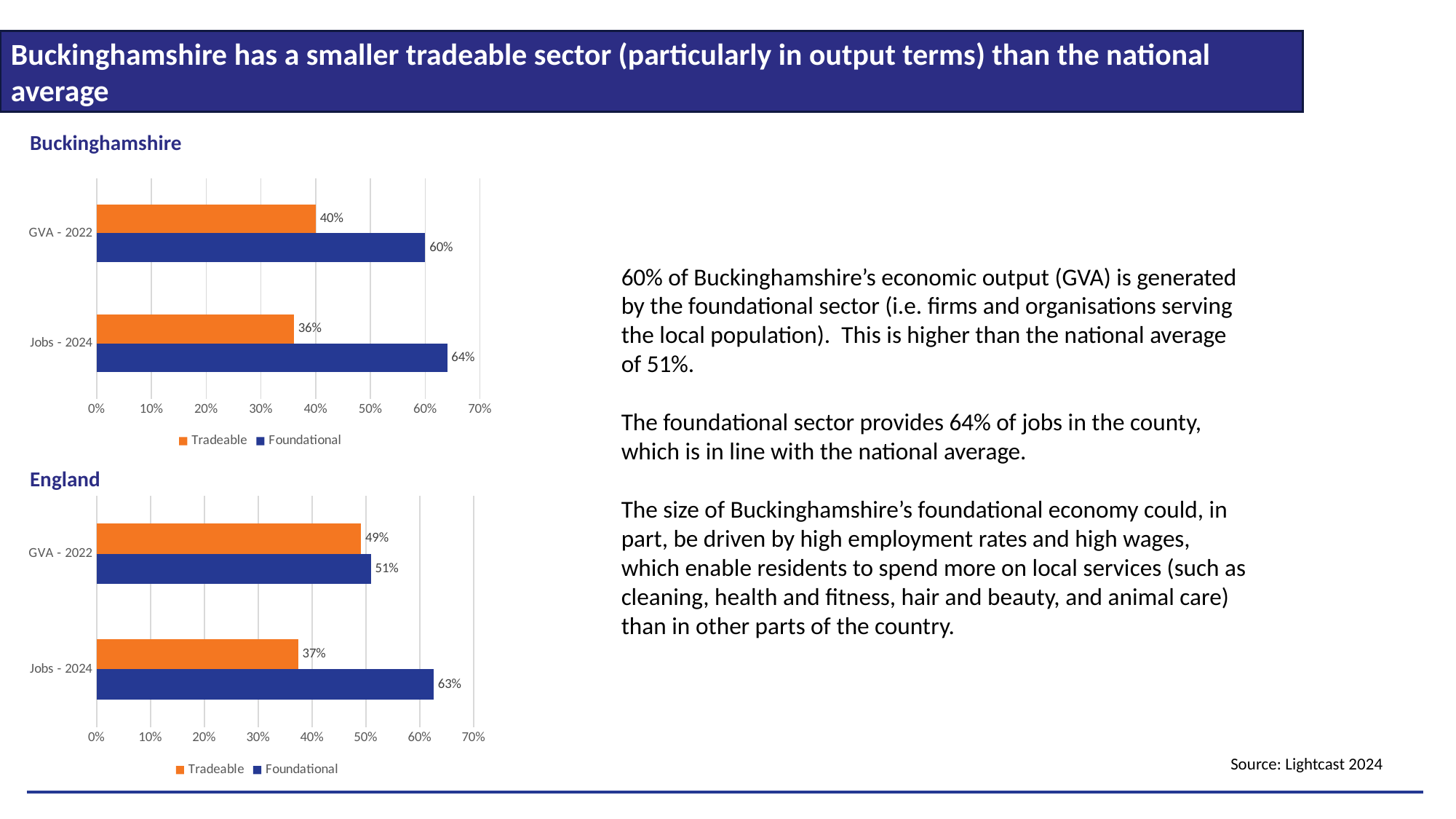
In the Buckinghamshire chart, what is the difference between the Foundational and Tradeable values for GVA - 2022? 20% What kind of chart is the England chart? Bar chart In the England chart, what is the Tradeable value for GVA - 2022? 49% In the England chart, which bar has the lowest value? Tradeable, Jobs - 2024 How many series does the legend of the England chart list? 2 In the England chart, what is the difference between the Foundational and Tradeable values for Jobs - 2024? 26% How many categories are shown on the y axis of the Buckinghamshire chart? 2 In the Buckinghamshire chart, what is the Tradeable value for Jobs - 2024? 36% In the Buckinghamshire chart, which series has the larger value for Jobs - 2024, Tradeable or Foundational? Foundational In the Buckinghamshire chart, what is the Foundational value for GVA - 2022? 60% In the Buckinghamshire chart, which bar has the highest value? Foundational, Jobs - 2024 In the England chart, what is the Foundational value for Jobs - 2024? 63%